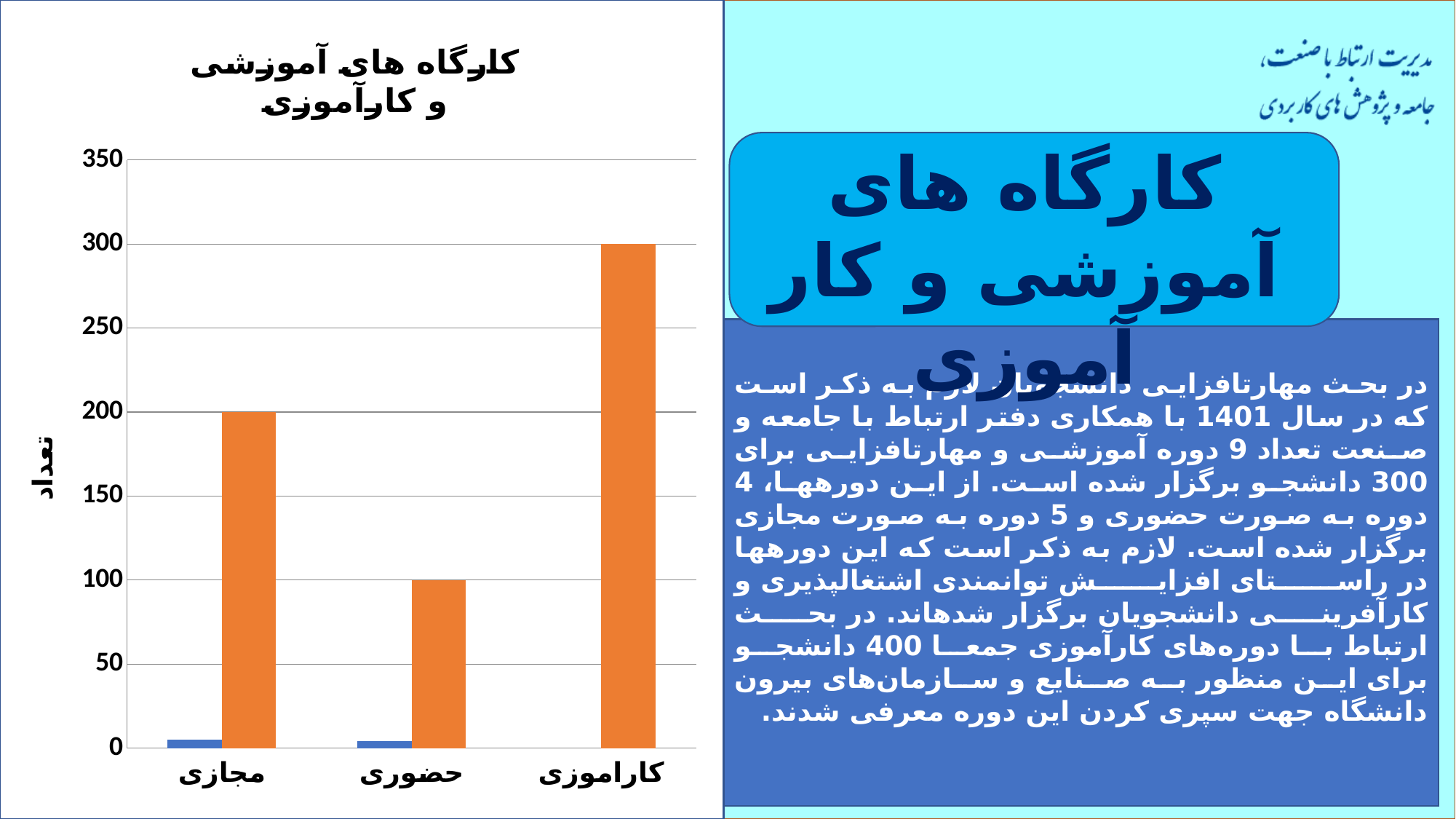
What kind of chart is shown on the slide? bar chart What is the value of the orange bar for کارآموزی? 300 What is the difference between the orange bars for مجازی and حضوری? 100 Which category has the highest orange bar? کاراموزی What is the value of the orange bar for حضوری? 100 How many categories are shown on the x axis of the chart? 3 What is the difference between the orange bars for کارآموزی and مجازی? 100 Which has a larger orange bar, مجازی or حضوری? مجازی What is the label on the y axis of the chart? تعداد Which category has the lowest orange bar? حضوری Is the value of the blue bar for مجازی greater or less than 50? less What is the value of the orange bar for مجازی? 200